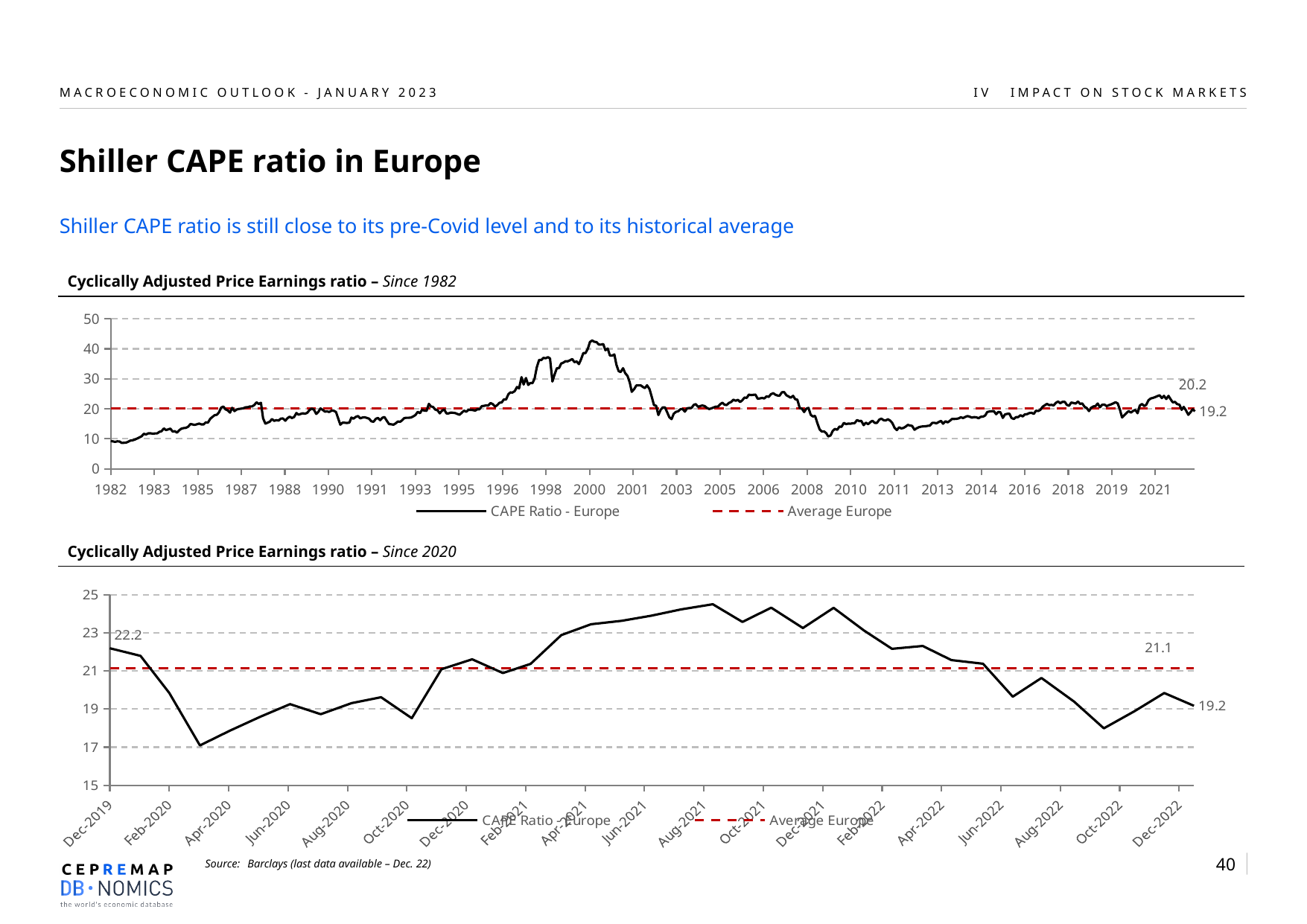
In the 'Since 2020' chart, what is the value of the CAPE Ratio - Europe at Dec-2019? 22.2 In the 'Since 2020' chart, what is the difference between the Dec-2019 value (22.2) and the Dec-2022 value (19.2) of the CAPE Ratio - Europe? 3.0 What type of chart is the 'Since 2020' chart? Line chart In the 'Since 1982' chart, is the peak of the CAPE Ratio - Europe around 2000 greater or less than 40? greater In the 'Since 2020' chart, what is the value of the CAPE Ratio - Europe at Dec-2022? 19.2 In the 'Since 2020' chart, what value is labelled for the Average Europe line? 21.1 In the 'Since 2020' chart, does the CAPE Ratio - Europe rise or fall between Aug-2021 and Dec-2022? Fall In the 'Since 1982' chart, what is the latest value of the CAPE Ratio - Europe series? 19.2 In the 'Since 1982' chart, what value is labelled for the Average Europe line? 20.2 How many series does the legend of the 'Since 1982' chart list? 2 In the 'Since 1982' chart, is the latest CAPE Ratio - Europe value (19.2) greater or less than the Average Europe value (20.2)? less In the 'Since 2020' chart, is the CAPE Ratio - Europe value at Apr-2020 greater or less than 19? less